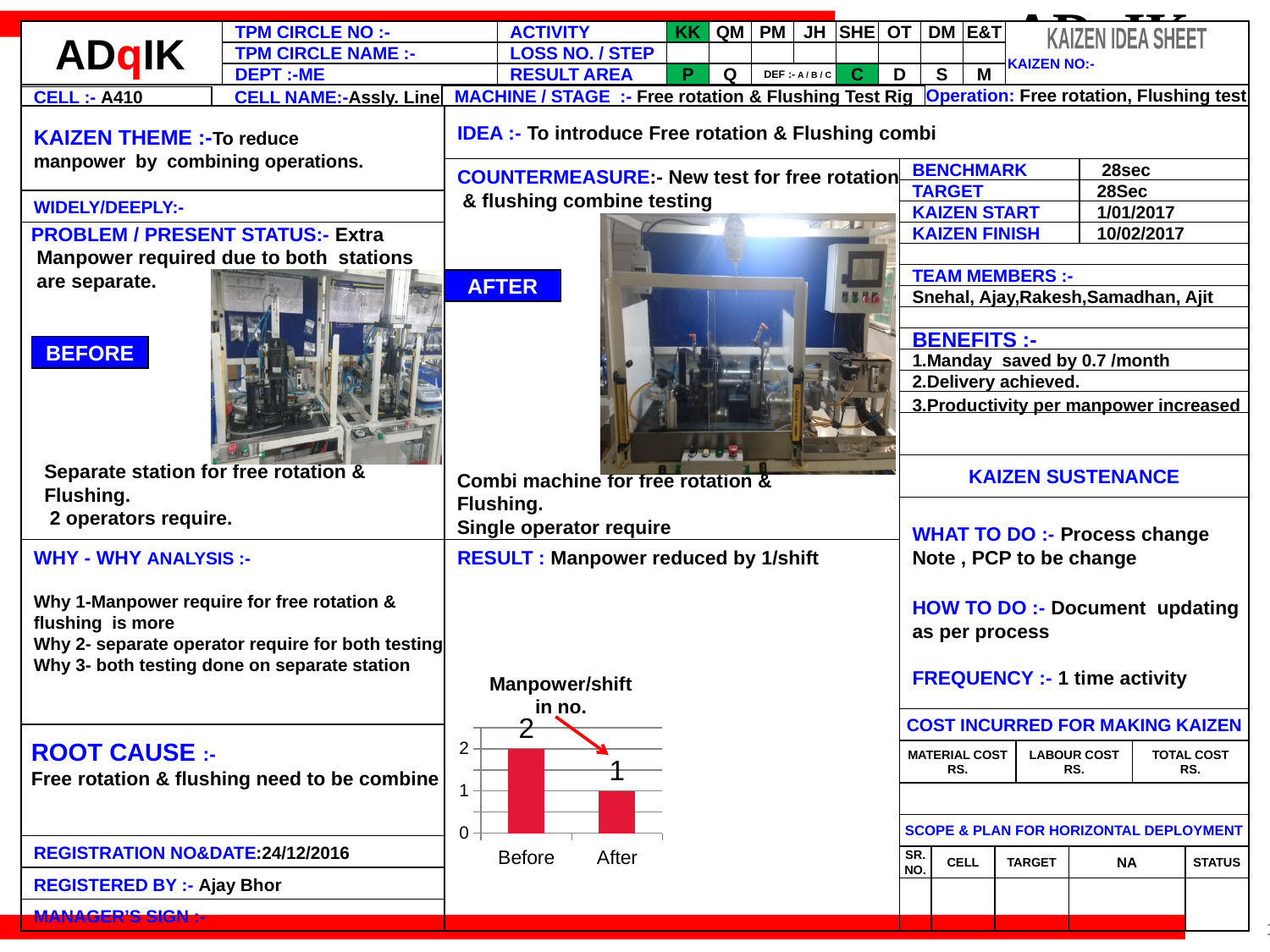
Is the value for Before larger or smaller than the value for After in the Manpower/shift in no. chart? larger How many categories are shown in the Manpower/shift in no. chart? 2 What is the difference between the Before and After values in the Manpower/shift in no. chart? 1 Do the values rise or fall from Before to After in the Manpower/shift in no. chart? fall Which category has the highest value in the Manpower/shift in no. chart? Before What is the value for After in the Manpower/shift in no. chart? 1 What kind of chart is the Manpower/shift in no. chart? bar chart What is the value for Before in the Manpower/shift in no. chart? 2 What is the highest tick value shown on the y axis of the Manpower/shift in no. chart? 2 Which category has the lowest value in the Manpower/shift in no. chart? After What is the title of the chart on the slide? Manpower/shift in no.